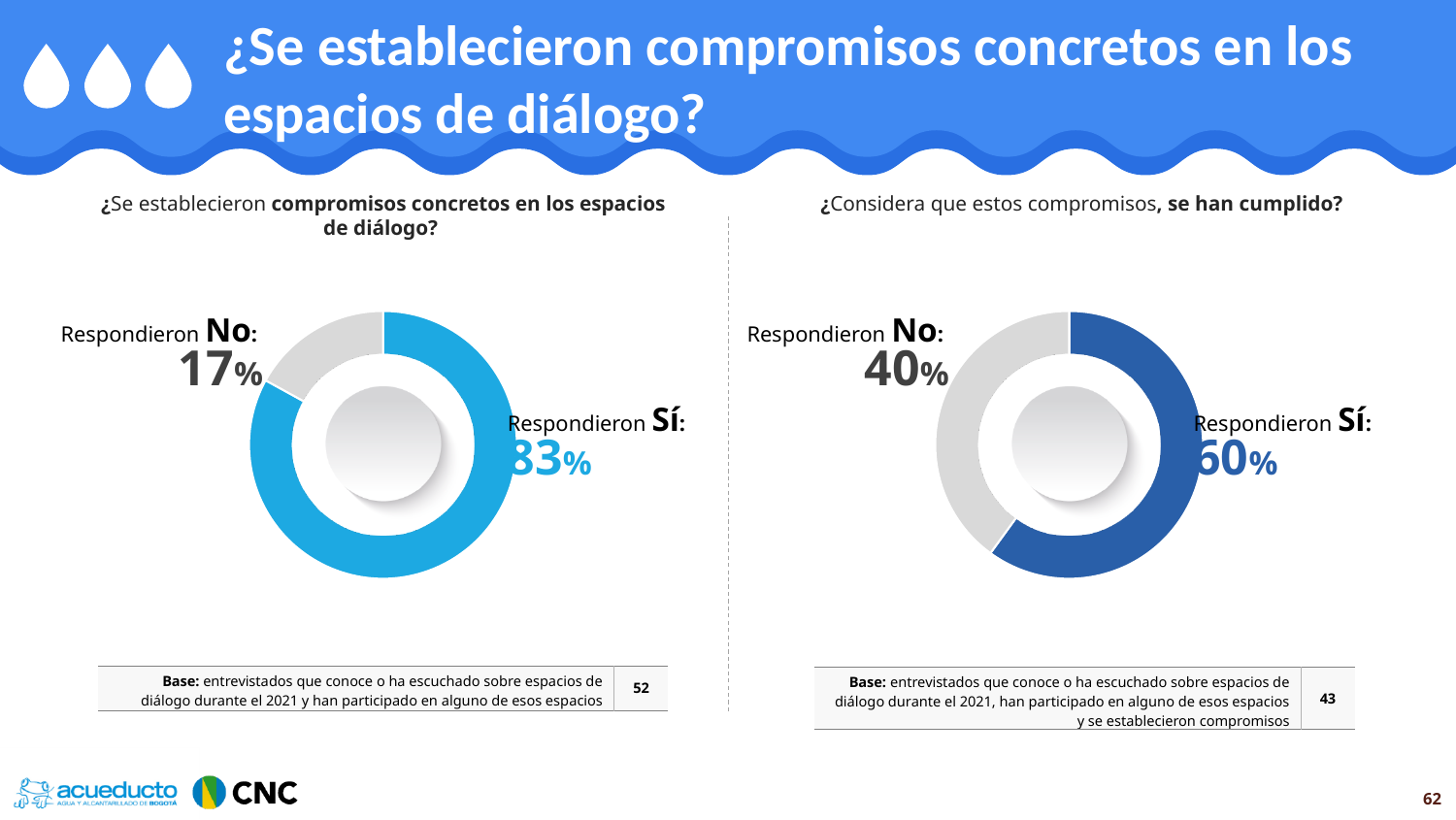
In the right chart (¿Considera que estos compromisos, se han cumplido?), what percentage answered No? 40% In the right chart (¿Considera que estos compromisos, se han cumplido?), what percentage answered Sí? 60% Which is larger: the Sí share in the left chart or the Sí share in the right chart? The left chart (83%) In the right chart (¿Considera que estos compromisos, se han cumplido?), what is the difference in percentage points between Sí and No? 20 What type of chart is used on this slide? Donut (pie) chart In the left chart (¿Se establecieron compromisos concretos en los espacios de diálogo?), which response has the larger share? Sí How many response categories does each chart on the slide show? 2 In the right chart (¿Considera que estos compromisos, se han cumplido?), which response has the smaller share? No What is the base (number of respondents) for the right chart (¿Considera que estos compromisos, se han cumplido?)? 43 In the left chart (¿Se establecieron compromisos concretos en los espacios de diálogo?), what is the difference in percentage points between Sí and No? 66 In the left chart (¿Se establecieron compromisos concretos en los espacios de diálogo?), what percentage answered No? 17% In the left chart (¿Se establecieron compromisos concretos en los espacios de diálogo?), what percentage answered Sí? 83%